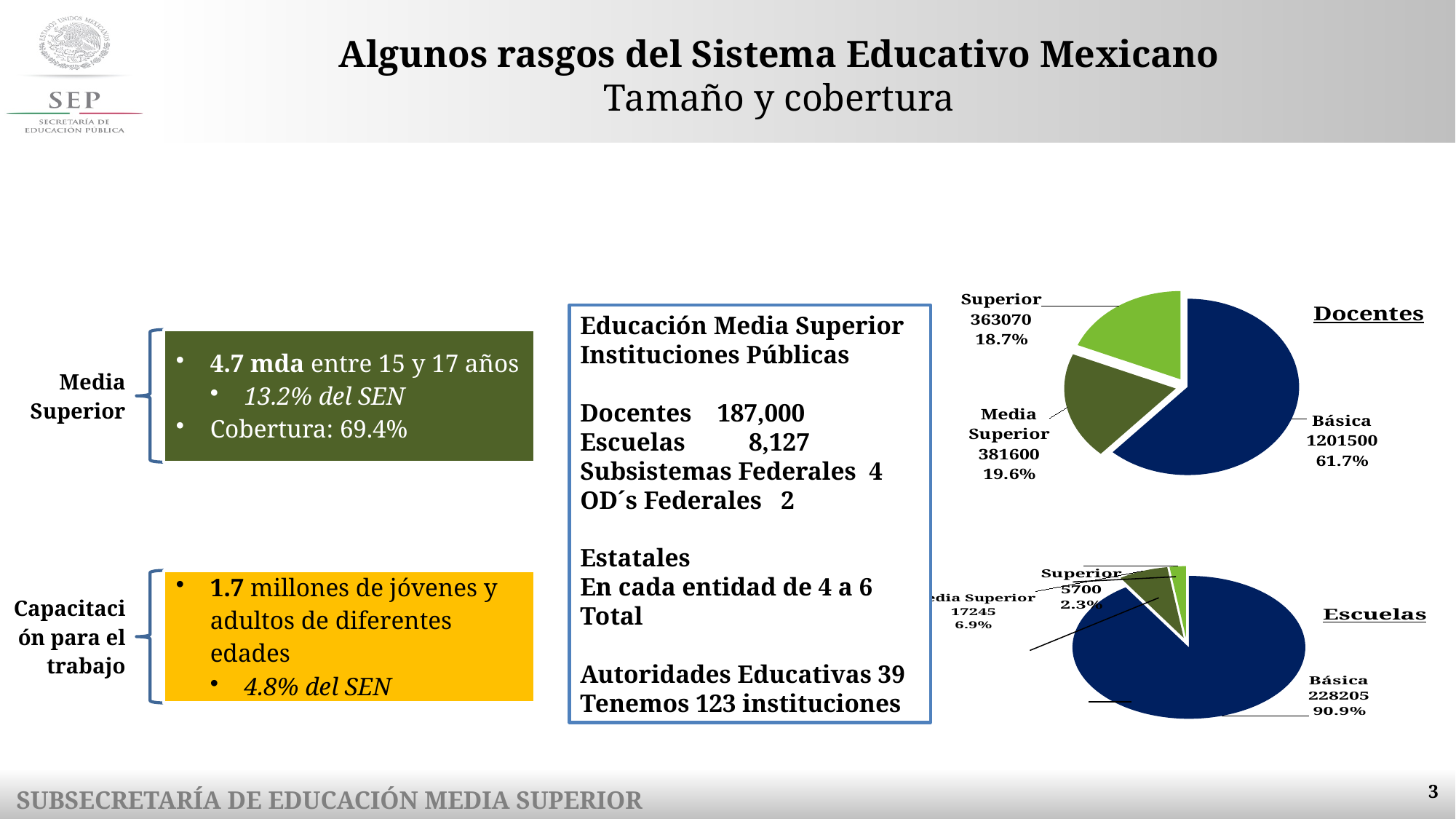
In the Escuelas pie chart, what value is shown for Media Superior? 17245 In the Docentes pie chart, which category has the smallest slice? Superior In the Docentes pie chart, what is the difference between the Media Superior and Superior values? 18530 In the Docentes pie chart, what value is shown for Superior? 363070 In the Docentes pie chart, which category has the largest slice? Básica In the Escuelas pie chart, which is larger, Media Superior or Superior? Media Superior In the Docentes pie chart, what percentage share is shown for Media Superior? 19.6% In the Escuelas pie chart, what percentage share is shown for Superior? 2.3% In the Escuelas pie chart, what value is shown for Básica? 228205 How many slices does the Escuelas pie chart have? 3 What type of chart is the Docentes chart? Pie chart In the Docentes pie chart, what value is shown for Básica? 1201500